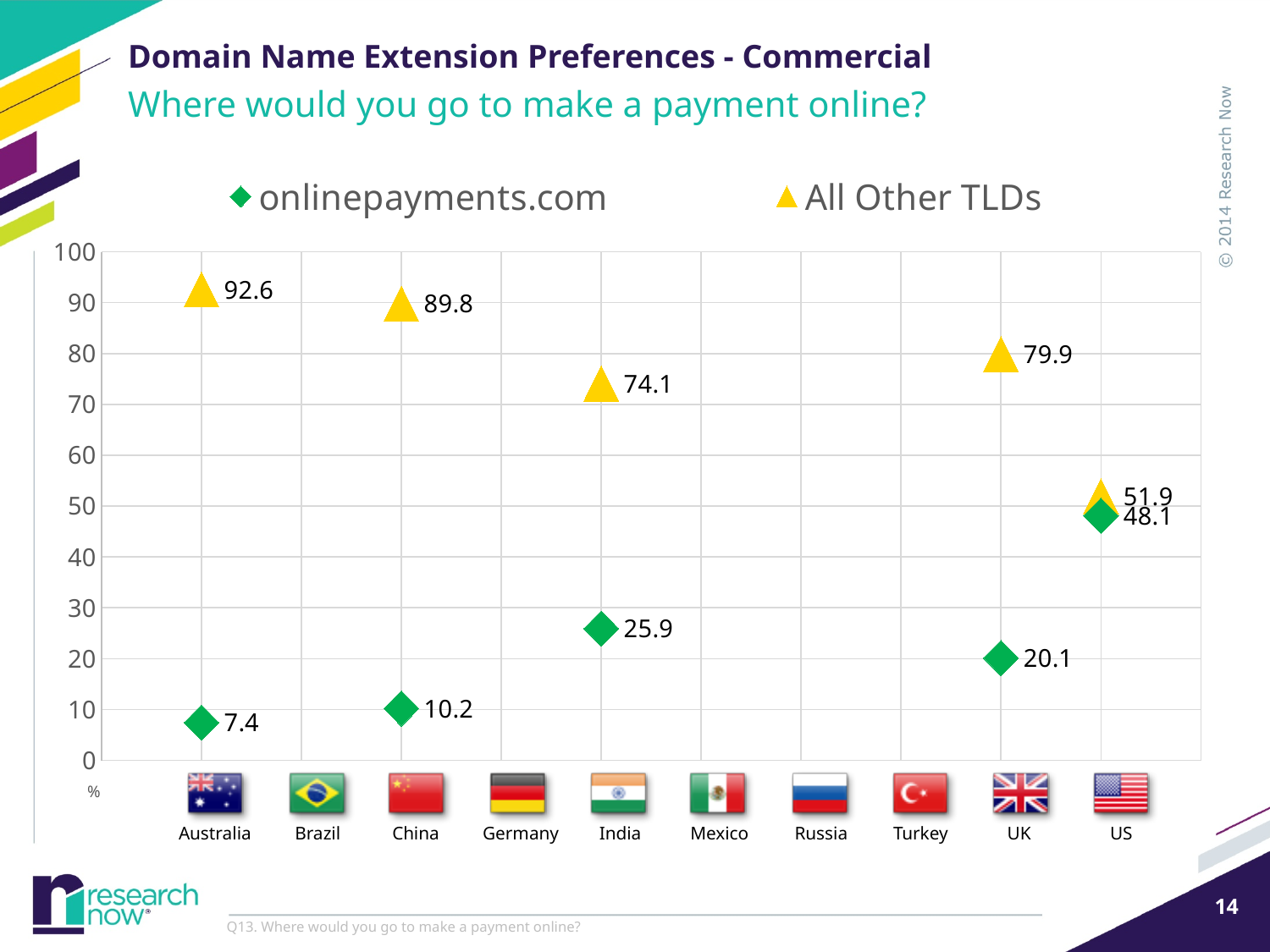
What is the value for All Other TLDs for the UK? 79.9 What is the value for onlinepayments.com for India? 25.9 Which country has the lowest value for onlinepayments.com? Australia Which is larger for the UK: the onlinepayments.com value or the All Other TLDs value? All Other TLDs What is the value for All Other TLDs for Australia? 92.6 What is the value for onlinepayments.com for the US? 48.1 What is the difference between the All Other TLDs value and the onlinepayments.com value for China? 79.6 Which marker shape represents All Other TLDs in the legend? Yellow triangle How many countries are listed along the x axis? 10 How many series does the legend list? 2 Which country has the highest value for All Other TLDs? Australia What kind of chart is shown on the slide? Scatter chart